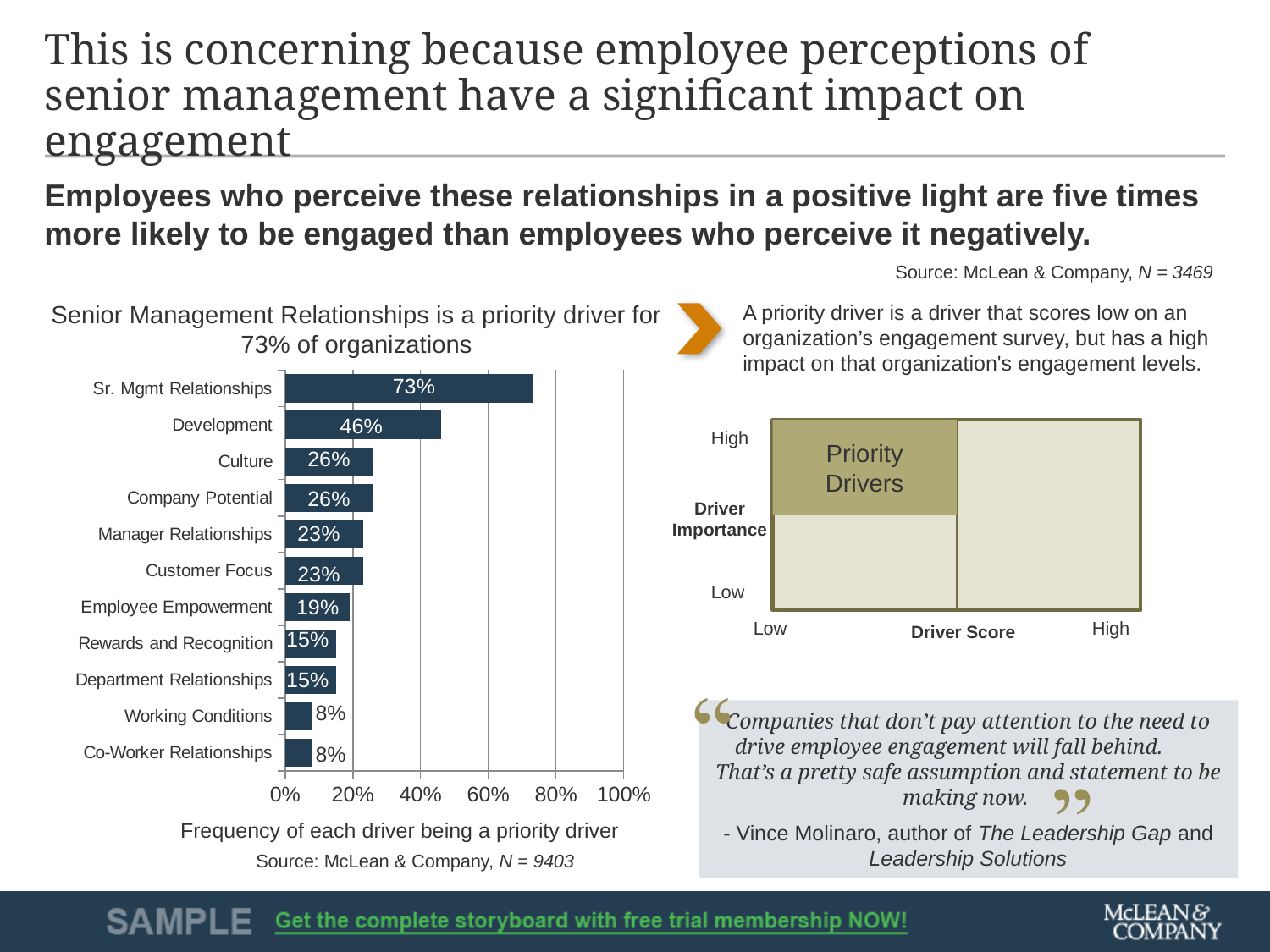
What is the difference between the values for Sr. Mgmt Relationships and Development? 27% What is the difference between the values for Culture and Customer Focus? 3% What is the title of the bar chart? Senior Management Relationships is a priority driver for 73% of organizations What kind of chart is used to show the frequency of each driver being a priority driver? bar chart Which category has the highest value? Sr. Mgmt Relationships What is the value for Employee Empowerment? 19% What is the value for Development? 46% How many categories are shown in the bar chart? 11 What is the value for Sr. Mgmt Relationships? 73% What is the value for Working Conditions? 8% Is the value for Sr. Mgmt Relationships greater or less than 60%? greater Which is larger, the value for Development or the value for Company Potential? Development